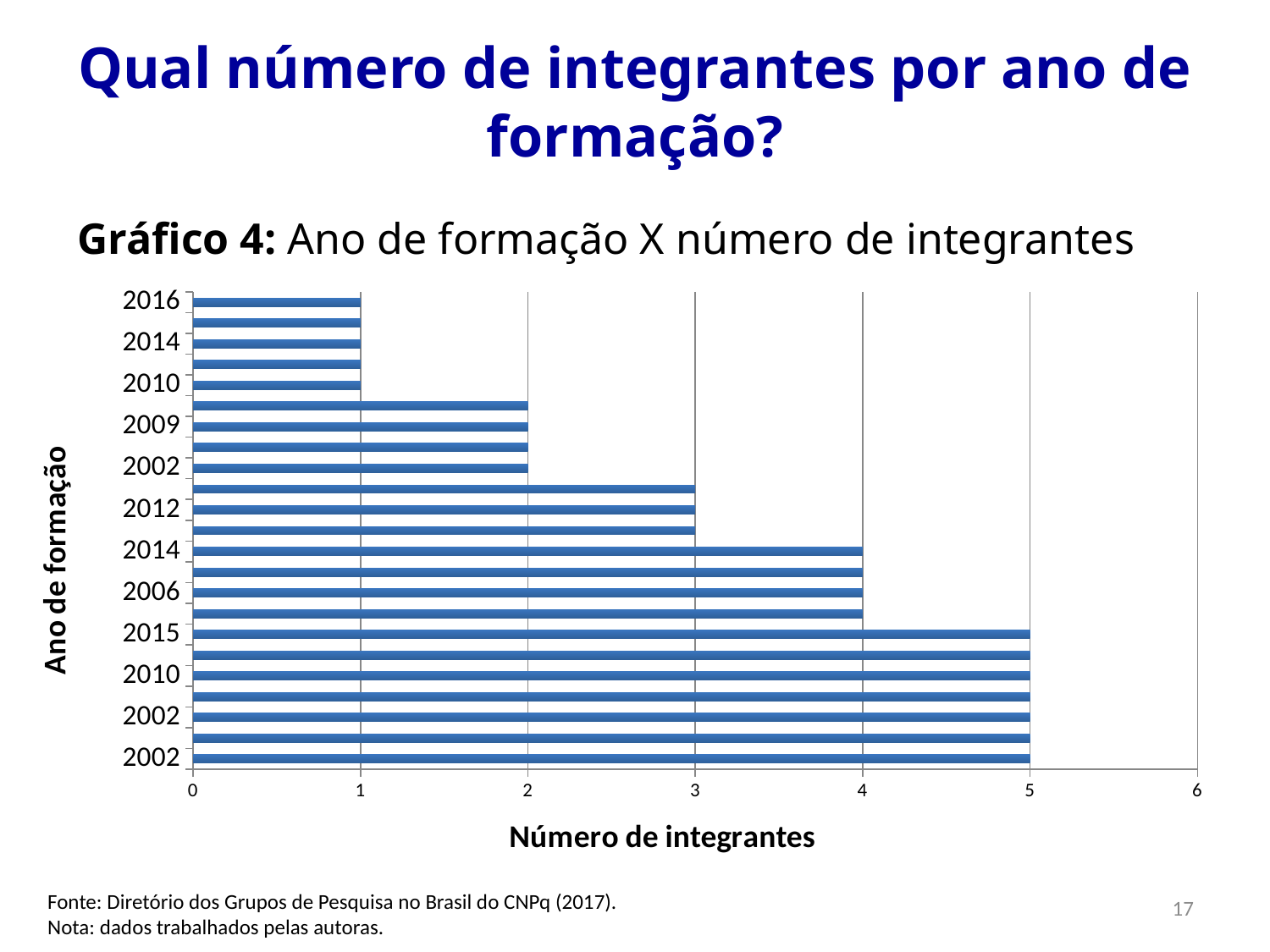
What is the number of integrantes for the bar labelled 2016 at the top of the chart? 1 What is the number of integrantes for the bar labelled 2006? 4 What is the number of integrantes for the bar labelled 2015? 5 What is the title of the x axis of the chart? Número de integrantes What is the highest number of integrantes reached by any bar in the chart? 5 What kind of chart is shown on the slide? bar chart What is the difference between the number of integrantes for 2015 and for 2009? 3 Which has more integrantes, the bar labelled 2012 or the bar labelled 2006? 2006 What is the number of integrantes for the bar labelled 2009? 2 What is the number of integrantes for the bar labelled 2012? 3 What is the title of the y axis of the chart? Ano de formação What is the lowest number of integrantes shown by any bar in the chart? 1